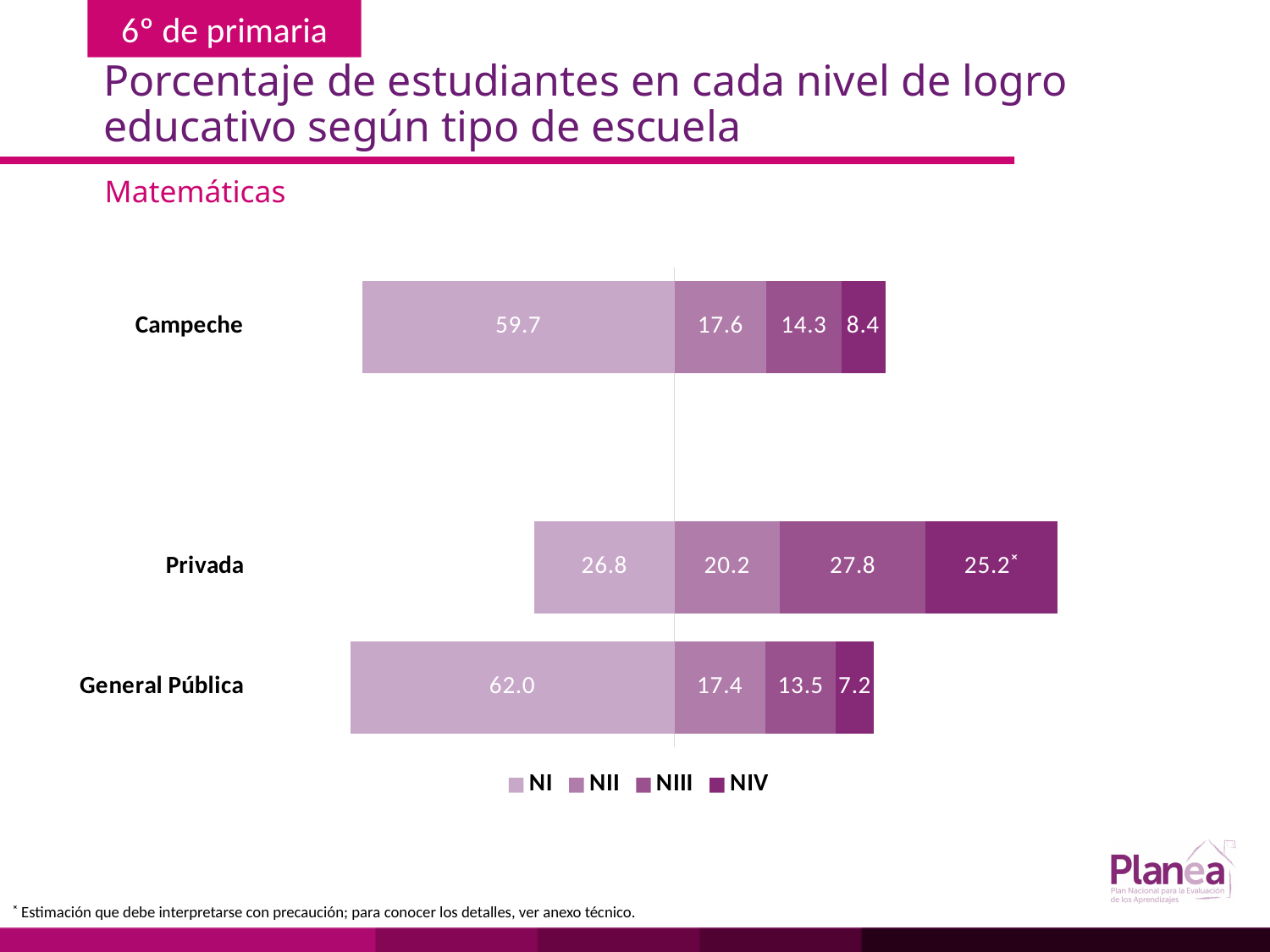
What is the NIII value for General Pública? 13.5 How many categories are shown on the chart? 3 Which is larger, the NIII value for Privada or the NIII value for Campeche? Privada Which category has the lowest NIV value? General Pública What is the NI value for Campeche? 59.7 Which category has the highest NI value? General Pública What is the difference between the NI values for General Pública and Privada? 35.2 What is the total of the stacked bar for Campeche? 100.0 What is the NII value for Campeche? 17.6 How many series does the legend list? 4 What is the NIV value for Privada? 25.2 What kind of chart is shown on the slide? Stacked bar chart